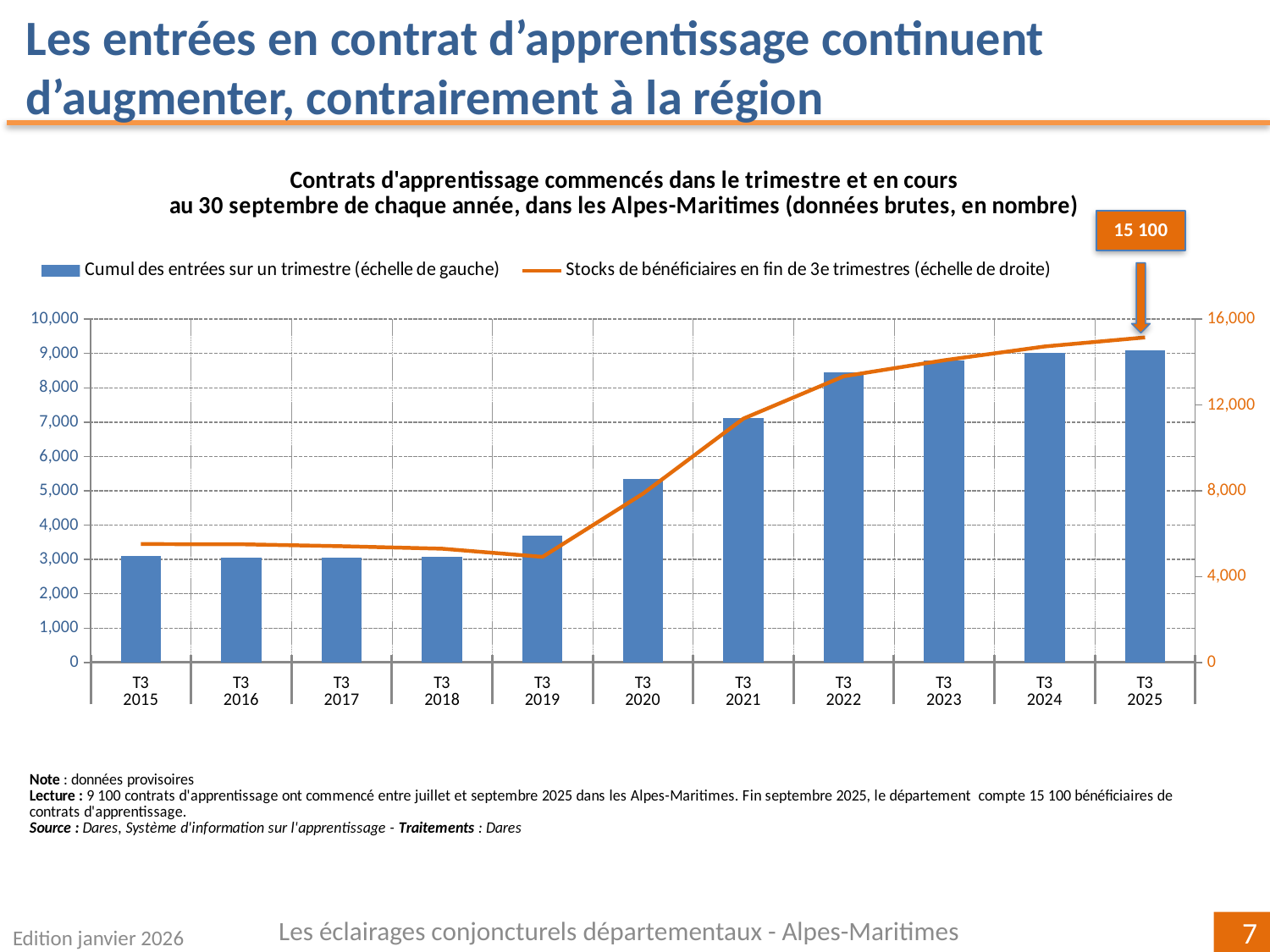
On the right-hand scale, is the 'Stocks de bénéficiaires' value for T3 2015 greater or less than 8,000? less Is the bar value for T3 2022 greater or less than 8,000? greater Which axis scale do the bars use, left or right? Left What value is shown by the data label on the line for T3 2025? 15 100 Which series is drawn as an orange line? Stocks de bénéficiaires en fin de 3e trimestres (échelle de droite) Do the bars for 'Cumul des entrées sur un trimestre' generally rise or fall from T3 2015 to T3 2025? Rise Which bar is taller, T3 2019 or T3 2020? T3 2020 Is the bar value for T3 2020 greater or less than 5,000? greater What kind of chart is this? Combined bar and line chart How many quarters (categories) are shown on the x axis? 11 How many series does the legend list? 2